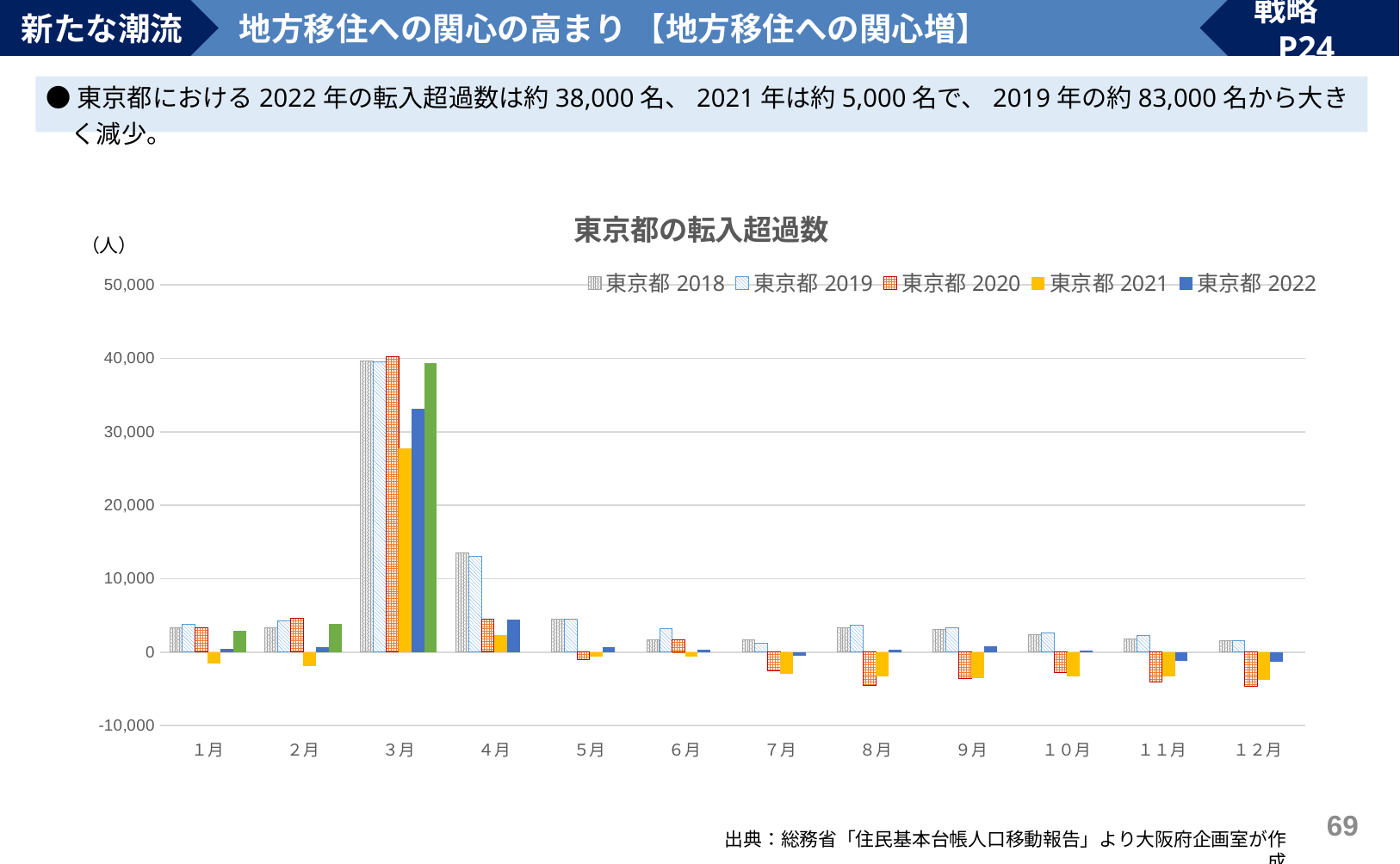
In 4月, which is larger: the value for 東京都 2018 or 東京都 2021? 東京都 2018 What is the title of the chart? 東京都の転入超過数 Is the value for 東京都 2021 in 3月 greater or less than 30,000? less Is the value for 東京都 2018 in 3月 greater or less than 30,000? greater How many series does the legend list? 5 What kind of chart is shown on the slide? bar chart Is the value for 東京都 2018 in 4月 greater or less than 10,000? greater How many months are shown along the x axis? 12 In 3月, which is larger: the value for 東京都 2021 or 東京都 2022? 東京都 2022 What unit is indicated for the y axis of the chart? 人 In which month are the bars highest? 3月